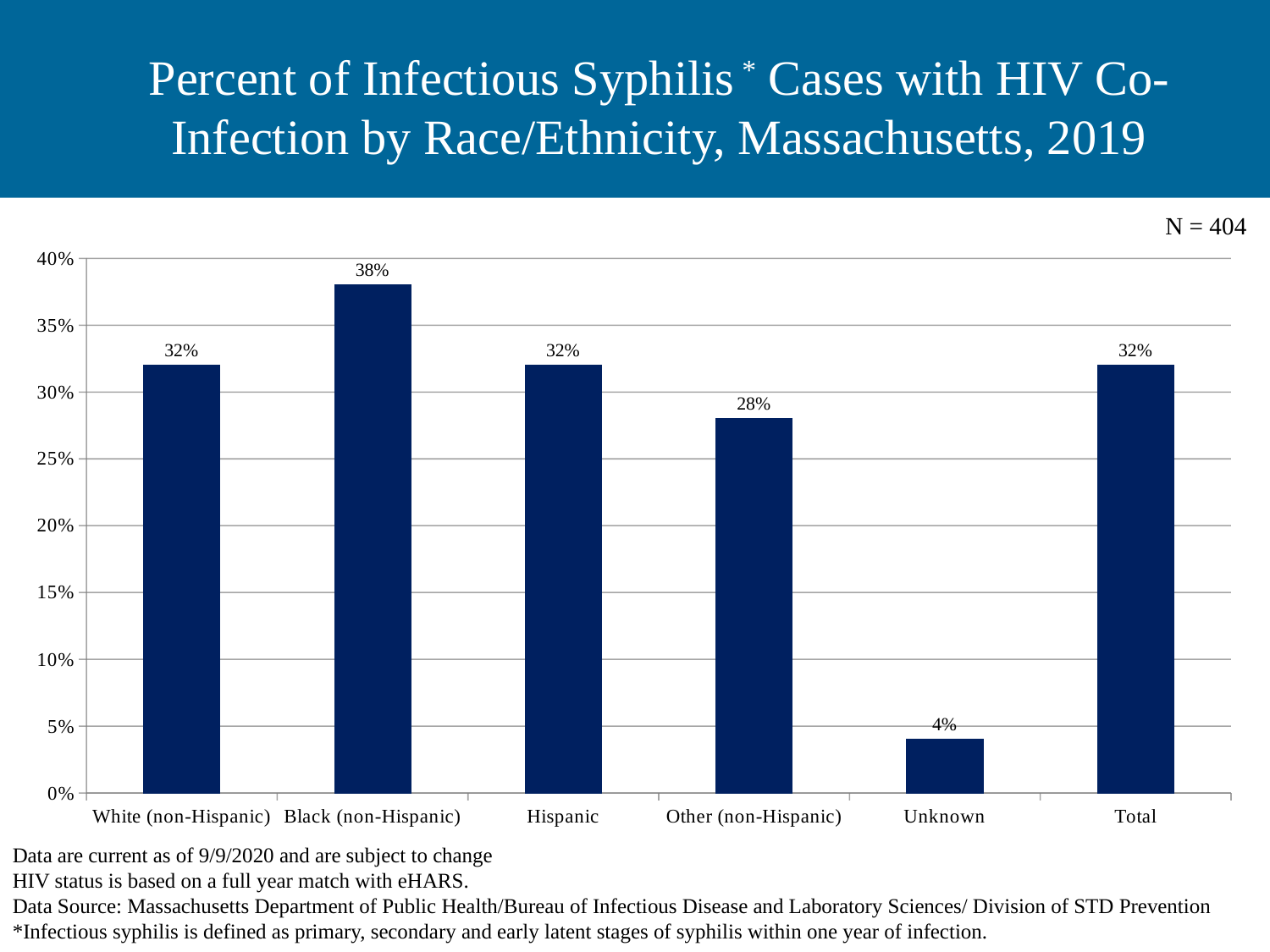
What kind of chart is shown on the slide? Bar chart What is the N value shown on the slide? N = 404 What is the difference between the values for Black (non-Hispanic) and Hispanic? 6% What is the difference between the values for Other (non-Hispanic) and Unknown? 24% What is the value shown for Other (non-Hispanic)? 28% What is the percent of infectious syphilis cases with HIV co-infection for Black (non-Hispanic)? 38% Which is larger, the value for Black (non-Hispanic) or the value for Other (non-Hispanic)? Black (non-Hispanic) Which race/ethnicity category has the highest percent of HIV co-infection? Black (non-Hispanic) Which category has the lowest value on the chart? Unknown How many categories are shown on the x axis? 6 What is the value shown for Unknown? 4% What is the value shown for the Total category? 32%